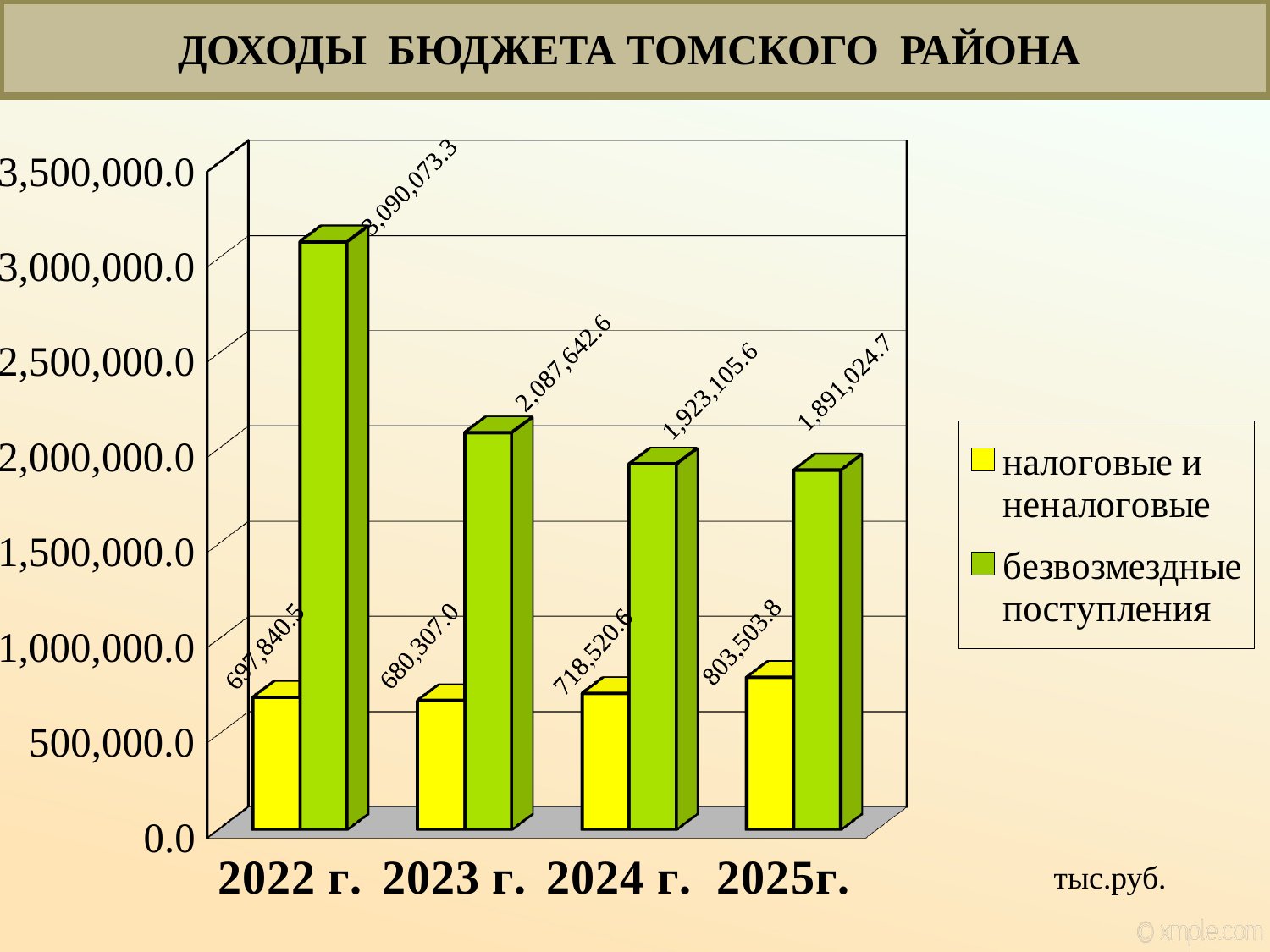
What is the difference between налоговые и неналоговые in 2025г. and in 2024 г.? 84,983.2 What is the value of налоговые и неналоговые for 2022 г.? 697,840.5 How many years are shown on the x axis? 4 What is the value of безвозмездные поступления for 2023 г.? 2,087,642.6 Which is larger: безвозмездные поступления in 2024 г. or in 2025г.? 2024 г. In which year is налоговые и неналоговые the lowest? 2023 г. How many series does the legend list? 2 What is the value of налоговые и неналоговые for 2025г.? 803,503.8 In which year is безвозмездные поступления the highest? 2022 г. Is the value of безвозмездные поступления for 2022 г. greater or less than 3,000,000.0? greater What type of chart is shown on the slide? bar chart What is the value of безвозмездные поступления for 2025г.? 1,891,024.7